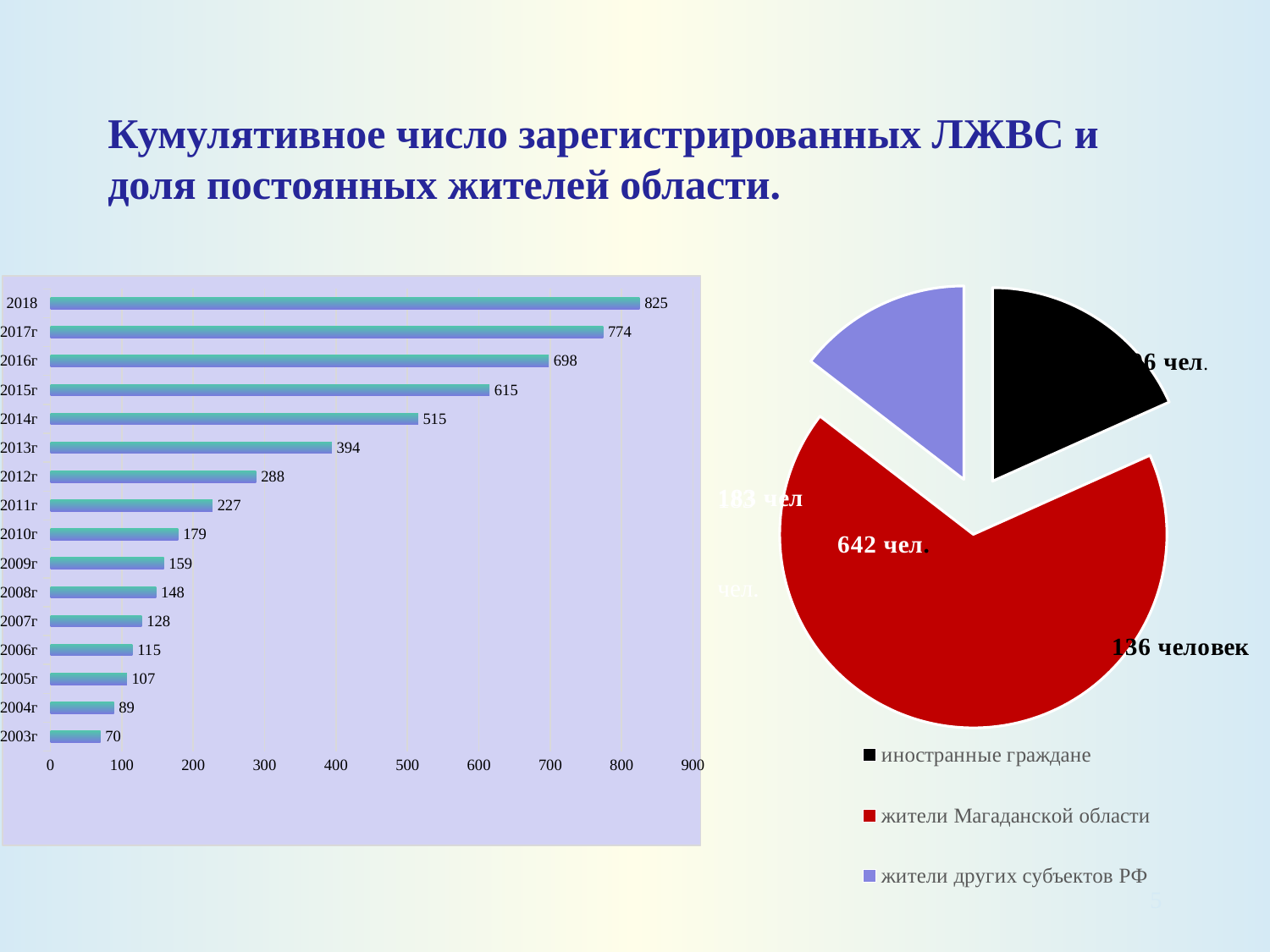
In the bar chart on the left, which year has the lowest value? 2003г In the bar chart on the left, how many years are shown? 16 In the pie chart on the right, how many categories does the legend list? 3 In the bar chart on the left, what is the difference between the values for 2018 and 2017г? 51 In the bar chart on the left, do the values rise or fall from 2003г to 2018? rise In the bar chart on the left, which is larger: the value for 2014г or the value for 2012г? 2014г What kind of chart is on the left side of the slide? bar chart In the bar chart on the left, what is the value for 2018? 825 What kind of chart is on the right side of the slide? pie chart In the bar chart on the left, what is the value for 2013г? 394 In the bar chart on the left, what is the value for 2003г? 70 In the bar chart on the left, which year has the highest value? 2018